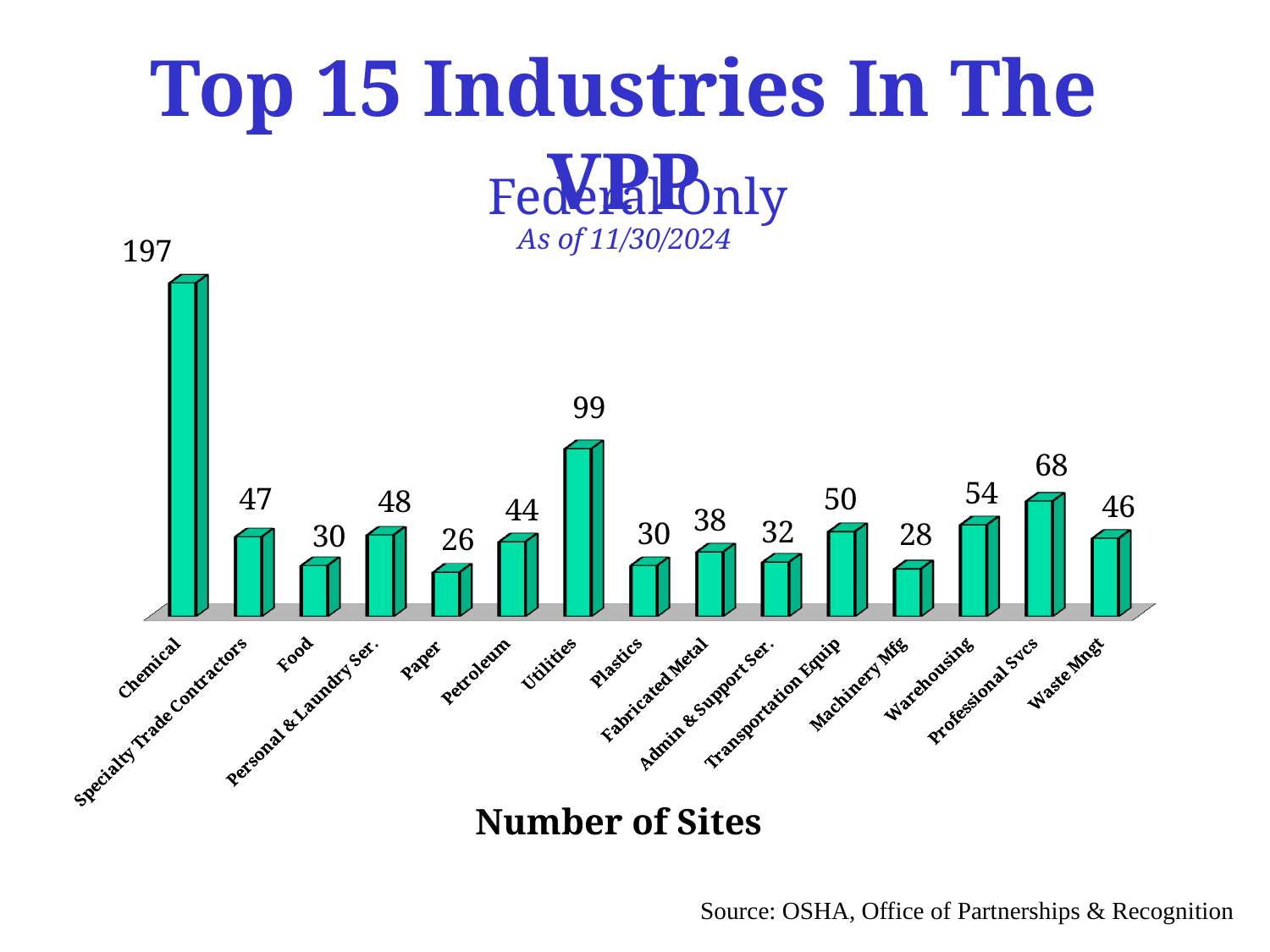
What is the number of sites for Utilities? 99 Which has more sites, Specialty Trade Contractors or Personal & Laundry Ser.? Personal & Laundry Ser. What kind of chart is shown on the slide? Bar chart What is the label on the horizontal axis of the chart? Number of Sites How many industries are shown on the chart? 15 How many sites does the Chemical industry have? 197 How many sites are shown for Paper? 26 Which industry has the lowest number of sites? Paper What is the value shown for Professional Svcs? 68 Which industry has the highest number of sites? Chemical What is the difference between Warehousing and Machinery Mfg? 26 What is the difference in number of sites between Chemical and Utilities? 98